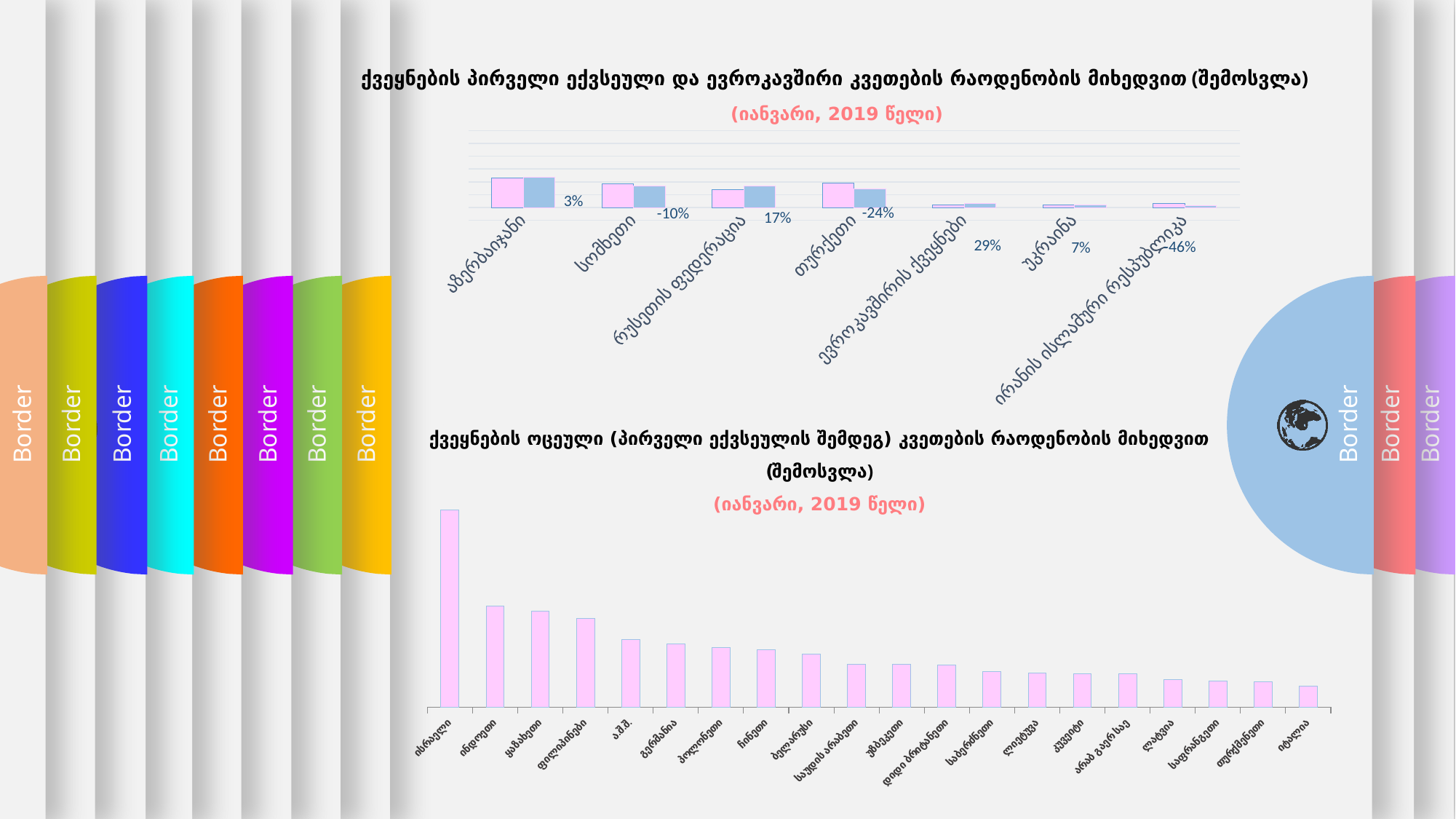
What kind of chart is the bottom chart? bar chart How many categories are shown on the x axis of the top chart? 7 In the top chart, which has taller bars, აზერბაიჯანი or უკრაინა? აზერბაიჯანი In the top chart, what percentage label is shown for ირანის ისლამური რესპუბლიკა? -46% In the bottom chart, which country has the highest bar? ისრაელი In the top chart, what percentage label is shown for სომხეთი? -10% In the bottom chart, do the bar values rise or fall from left to right? fall In the top chart, what percentage label is shown for ევროკავშირის ქვეყნები? 29% In the bottom chart, which has the taller bar, ფილიპინები or ა.შ.შ.? ფილიპინები How many countries are shown on the x axis of the bottom chart? 20 In the top chart, what percentage label is shown for თურქეთი? -24% In the top chart, what percentage label is shown for აზერბაიჯანი? 3%